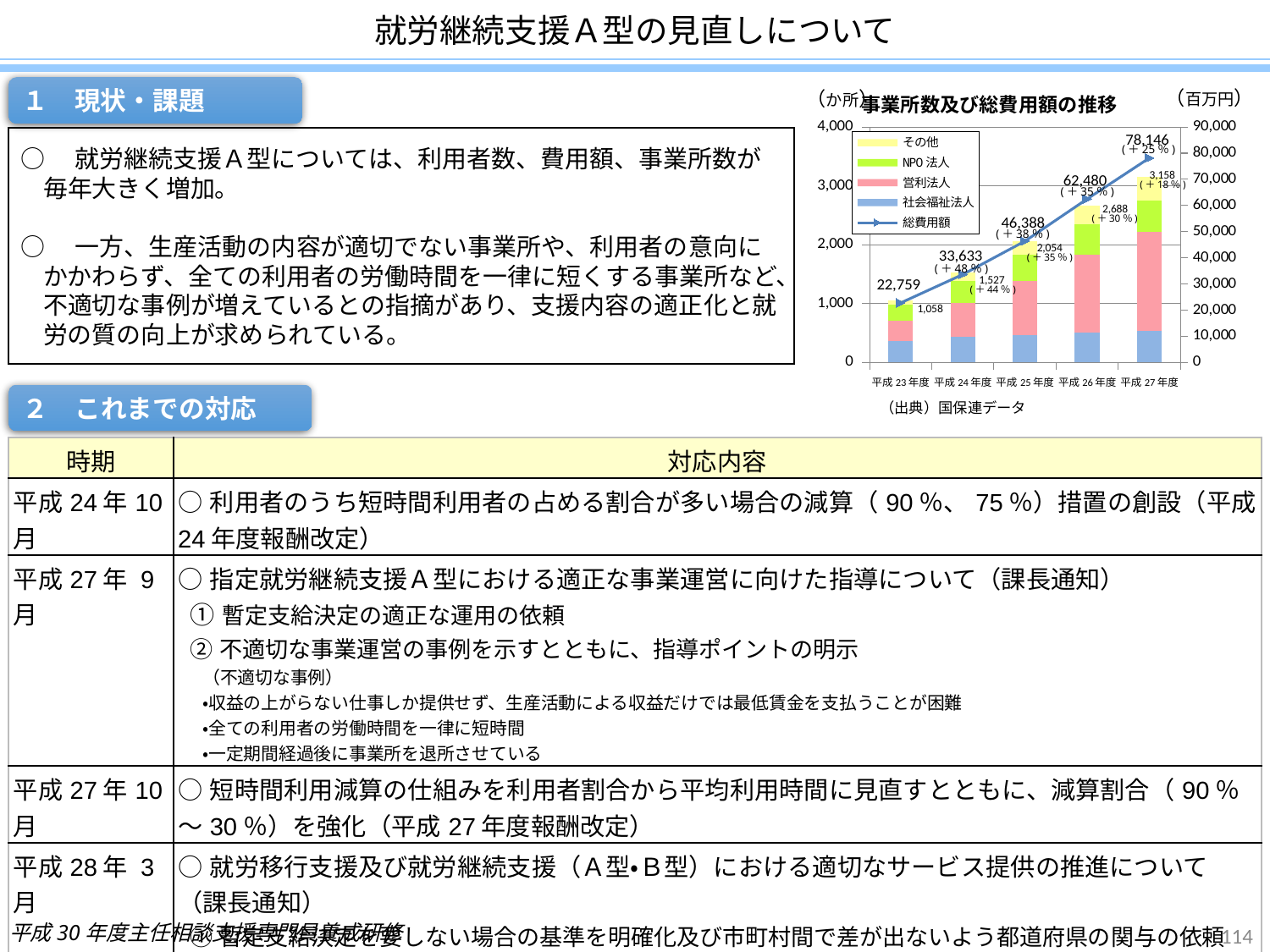
What is the title of the chart on the slide? 事業所数及び総費用額の推移 What is the 総費用額 value for 平成25年度? 46,388 Which fiscal year has the lowest bar total (number of 事業所)? 平成23年度 What is the total number of 事業所 (bar total) for 平成27年度? 3,158 Does the 総費用額 line rise or fall from 平成23年度 to 平成27年度? rise Is the 社会福祉法人 segment of the 平成27年度 bar greater or less than 1,000? less What kind of chart is shown on the slide? stacked bar chart with a line What is the difference in 総費用額 between 平成27年度 and 平成26年度? 15,666 How many fiscal years (categories) are shown on the x axis of the chart? 5 How many series does the chart's legend list? 5 What is the total number of 事業所 for 平成23年度? 1,058 Which fiscal year has the highest 総費用額? 平成27年度